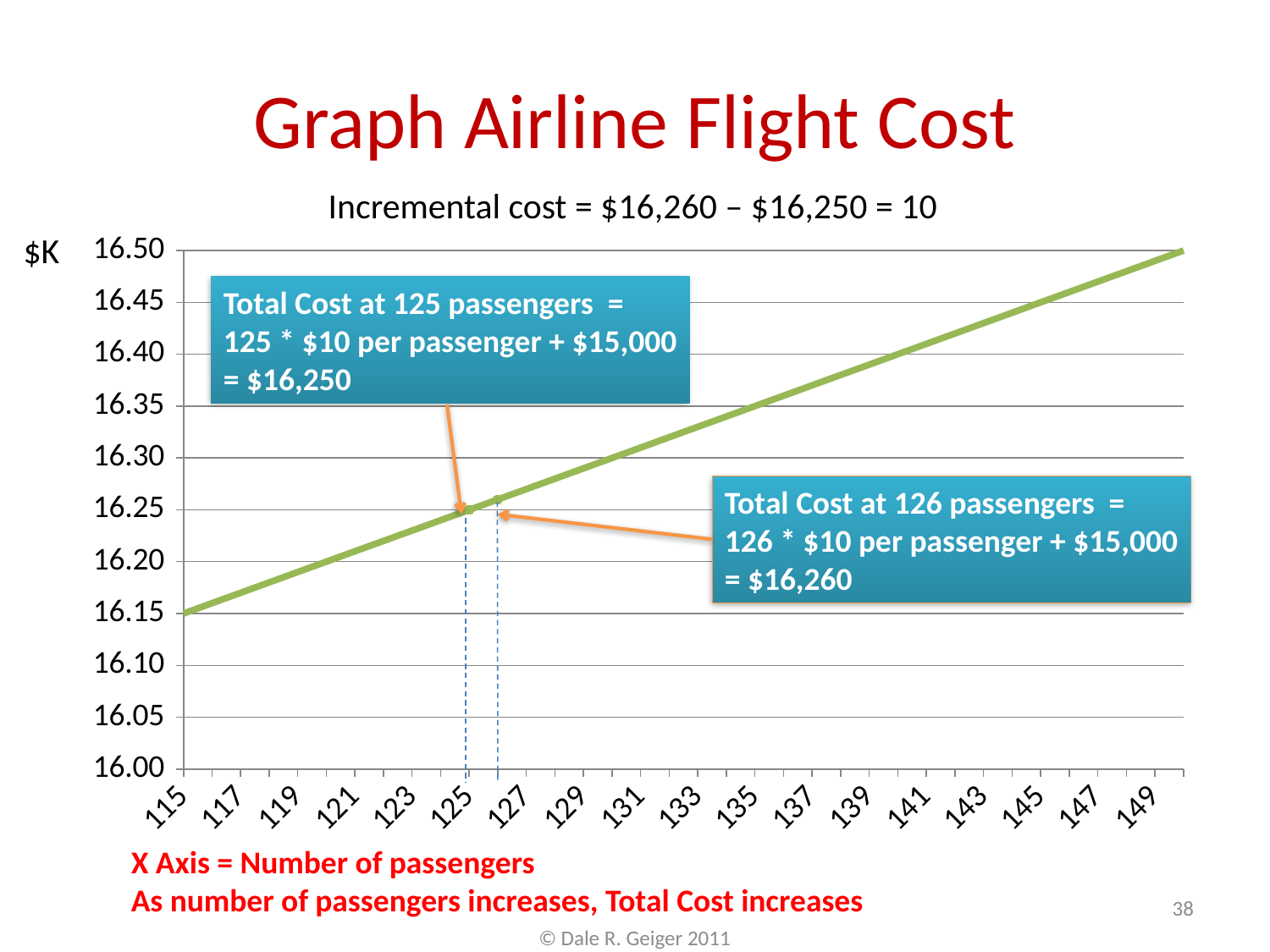
What is the total cost at 126 passengers? $16,260 What unit label is shown next to the y axis? $K Is the total cost at 135 passengers greater or less than 16.30? greater Does total cost rise or fall as the number of passengers increases along the x axis? rises What does the x axis represent? Number of passengers What is the incremental cost between 125 and 126 passengers? 10 What kind of chart is shown on the slide? line chart Which has the larger total cost, 125 passengers or 126 passengers? 126 passengers What is the total cost at 125 passengers? $16,250 Is the total cost at 145 passengers greater or less than 16.40? greater Is the total cost at 117 passengers greater or less than 16.25? less